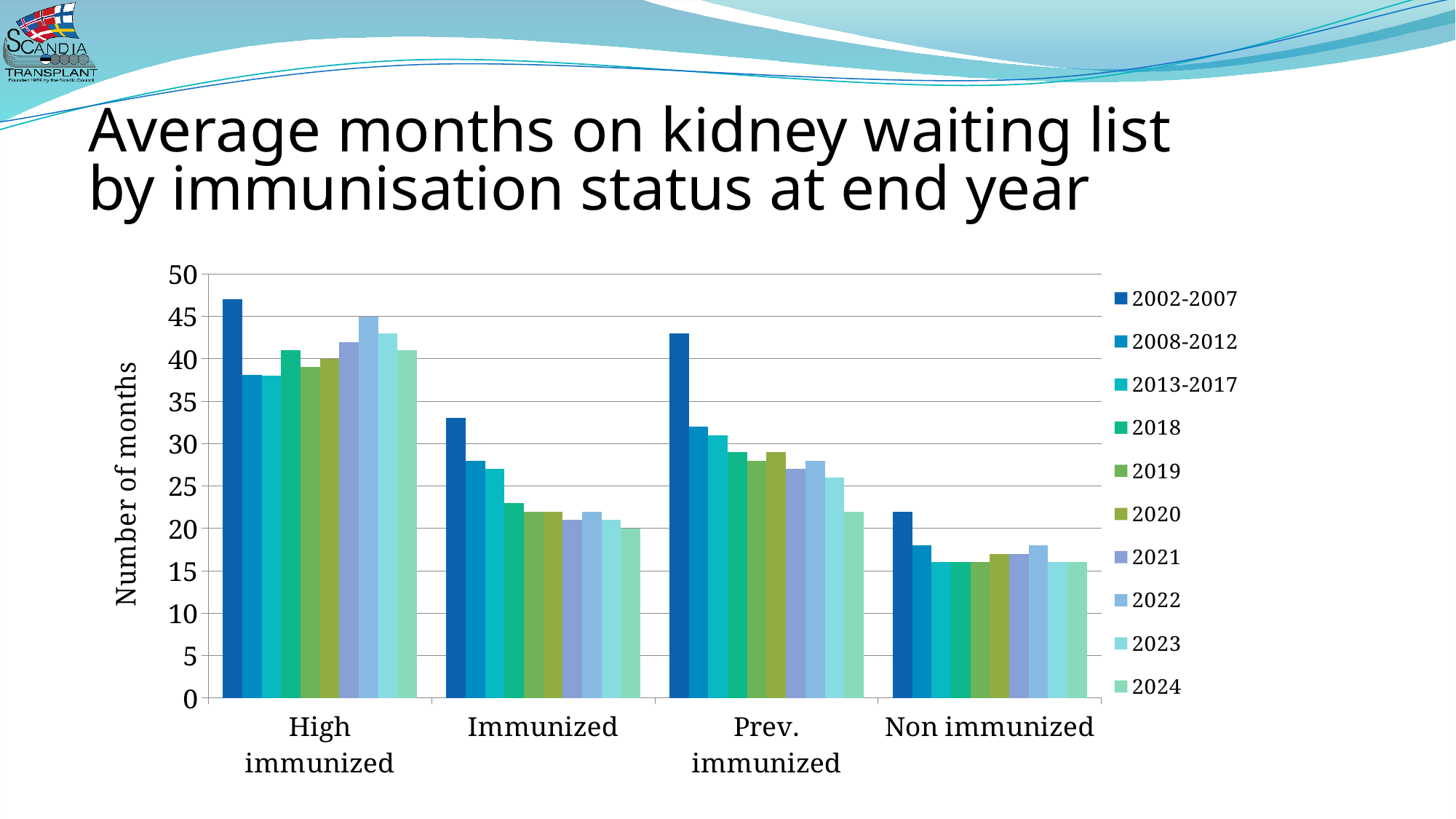
Which category has the lowest value for 2024? Non immunized Which category has the highest value for 2002-2007? High immunized What is the title of the y axis? Number of months Is the value for Non immunized in 2002-2007 greater or less than 20? greater Is the value for Immunized in 2024 greater or less than 25? less How many immunisation status categories are shown on the x axis? 4 For 2002-2007, which is larger: High immunized or Immunized? High immunized How many series does the legend list? 10 Is the value for High immunized in 2002-2007 greater or less than 45? greater What kind of chart is shown on the slide? bar chart Within the Immunized category, do the values generally rise or fall from 2002-2007 to 2024? fall